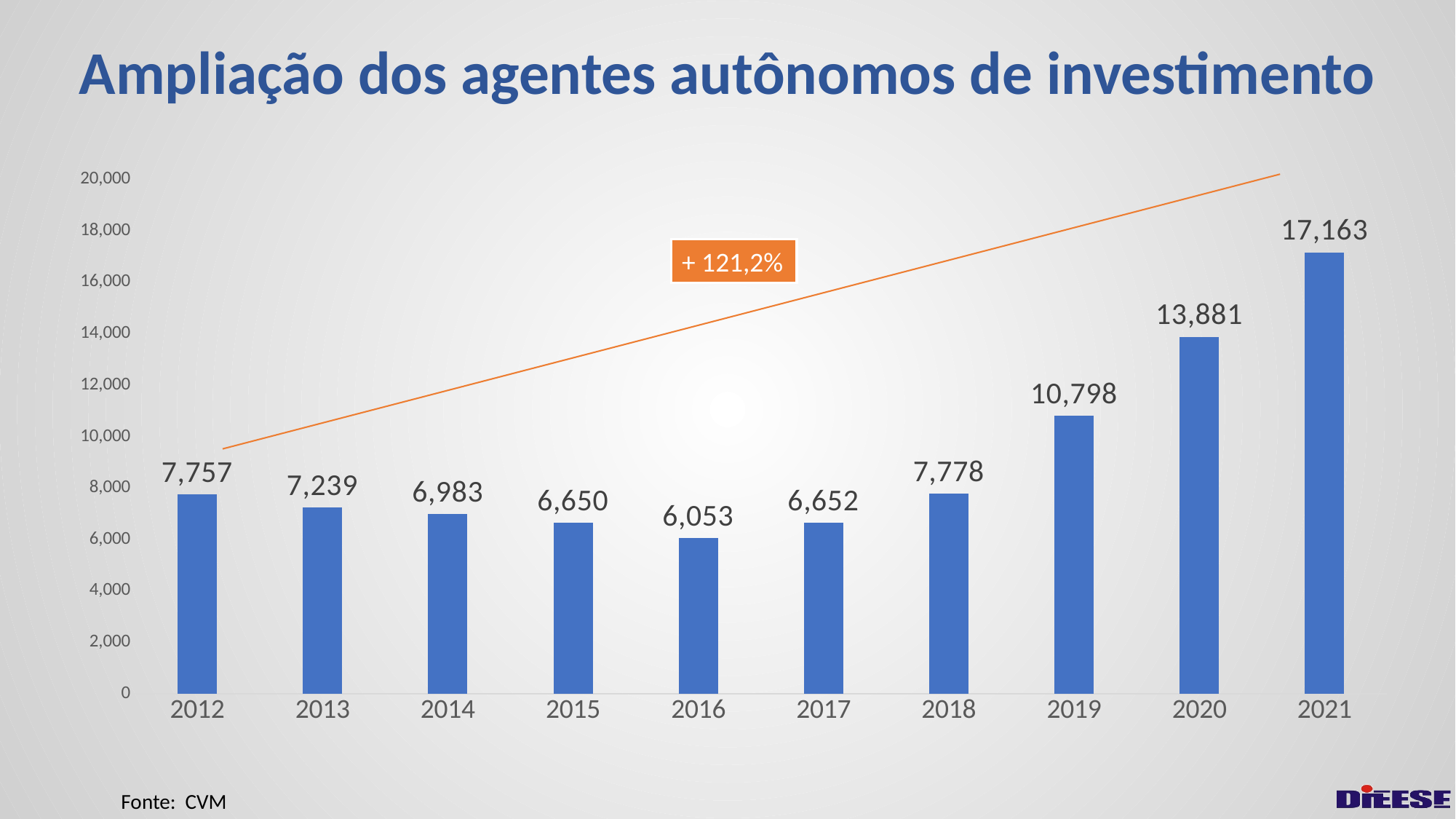
Which is larger, the value for 2013 or the value for 2018? 2018 Is the value for 2020 greater or less than 12,000? greater What is the value for 2019? 10,798 What kind of chart is shown on the slide? bar chart Which year has the lowest value? 2016 What is the value for 2021? 17,163 What is the difference between the values for 2020 and 2019? 3,083 What is the difference between the values for 2021 and 2012? 9,406 What percentage change is shown in the orange label on the chart? + 121,2% How many years are shown on the x axis? 10 What is the value for 2016? 6,053 Which year has the highest value? 2021